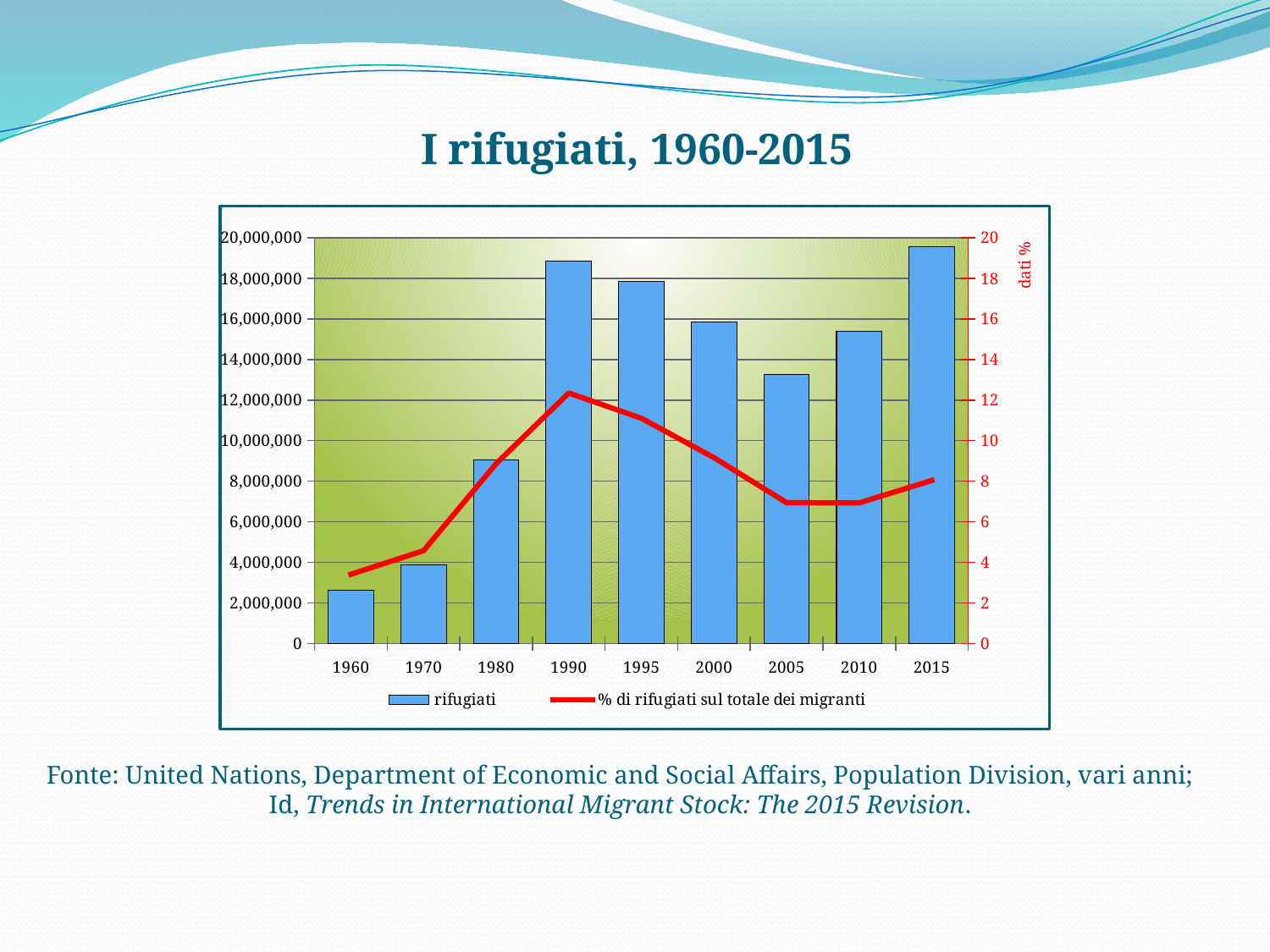
In which year does the line '% di rifugiati sul totale dei migranti' reach its highest point? 1990 Is the 'rifugiati' value for 2005 greater or less than 14,000,000? less Is the 'rifugiati' value for 1990 greater or less than 18,000,000? greater What is the title of the chart on the slide? I rifugiati, 1960-2015 In which year is the 'rifugiati' bar the lowest? 1960 Which year has the larger 'rifugiati' bar, 1995 or 2000? 1995 How many series does the chart legend list? 2 How many years are shown on the x axis of the chart? 9 What kind of chart is shown on the slide? A bar chart combined with a line Do the 'rifugiati' bars rise or fall from 1960 to 1990? rise In which year is the 'rifugiati' bar the highest? 2015 Is the '% di rifugiati sul totale dei migranti' value for 2005 greater or less than 8? less